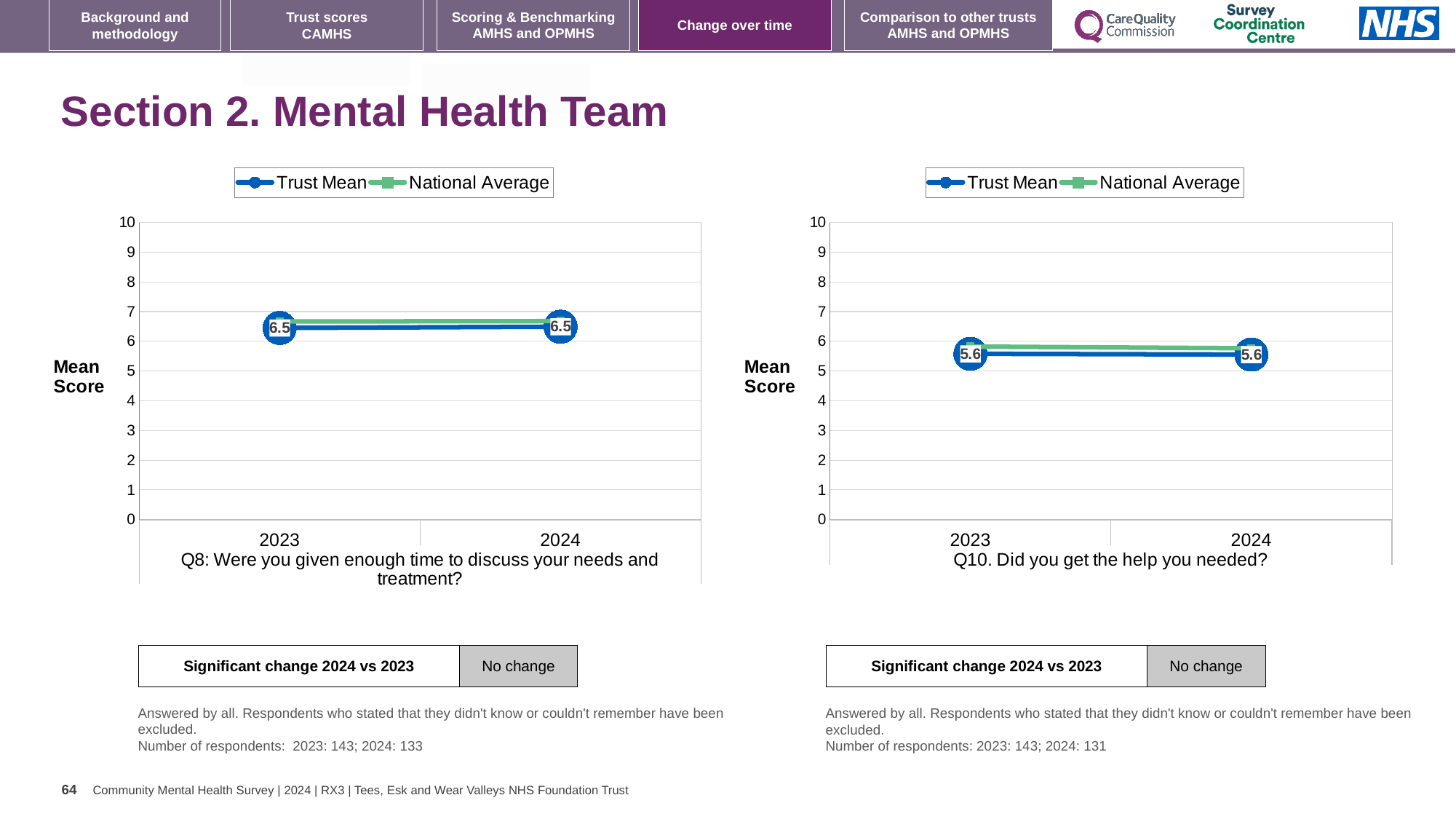
What are the two series named in the legend of the left chart (Q8)? Trust Mean and National Average How many series does the legend of the right chart (Q10) list? 2 On the left chart (Q8), what is the Trust Mean score for 2023? 6.5 On the right chart (Q10), is the National Average for 2023 greater or less than 7? less What kind of chart is the left chart (Q8)? line chart On the right chart (Q10), does the Trust Mean rise, fall or stay the same from 2023 to 2024? stays the same On the left chart (Q8), what is the Trust Mean score for 2024? 6.5 On the right chart (Q10), what is the Trust Mean score for 2024? 5.6 On the left chart (Q8), what is the difference between the Trust Mean in 2024 and in 2023? 0 On the left chart (Q8), is the National Average for 2024 greater or less than 6? greater How many years are shown on the x axis of the left chart (Q8)? 2 On the right chart (Q10), what is the Trust Mean score for 2023? 5.6